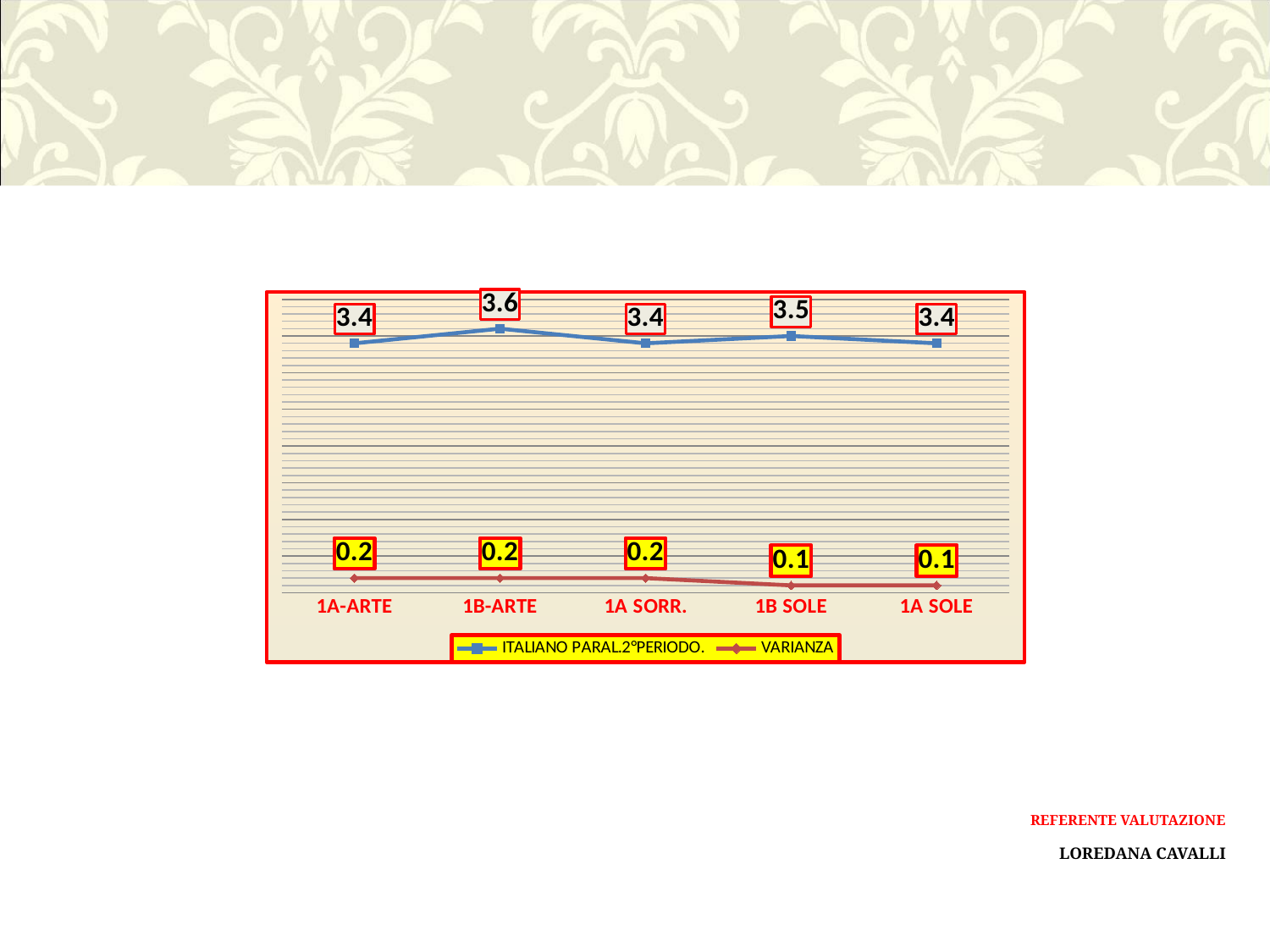
What is the VARIANZA value for 1B SOLE? 0.1 Which category has the highest ITALIANO PARAL.2°PERIODO. value? 1B-ARTE What kind of chart is shown on the slide? line chart How many categories are shown on the x axis? 5 What is the difference between the ITALIANO PARAL.2°PERIODO. values for 1B-ARTE and 1A-ARTE? 0.2 What are the two series names listed in the legend? ITALIANO PARAL.2°PERIODO. and VARIANZA What is the ITALIANO PARAL.2°PERIODO. value for 1A SOLE? 3.4 Which is larger, the ITALIANO PARAL.2°PERIODO. value for 1B SOLE or for 1A SORR.? 1B SOLE What is the ITALIANO PARAL.2°PERIODO. value for 1B-ARTE? 3.6 How many series does the legend list? 2 What is the VARIANZA value for 1A-ARTE? 0.2 Does the VARIANZA series rise or fall from 1A SORR. to 1B SOLE? fall